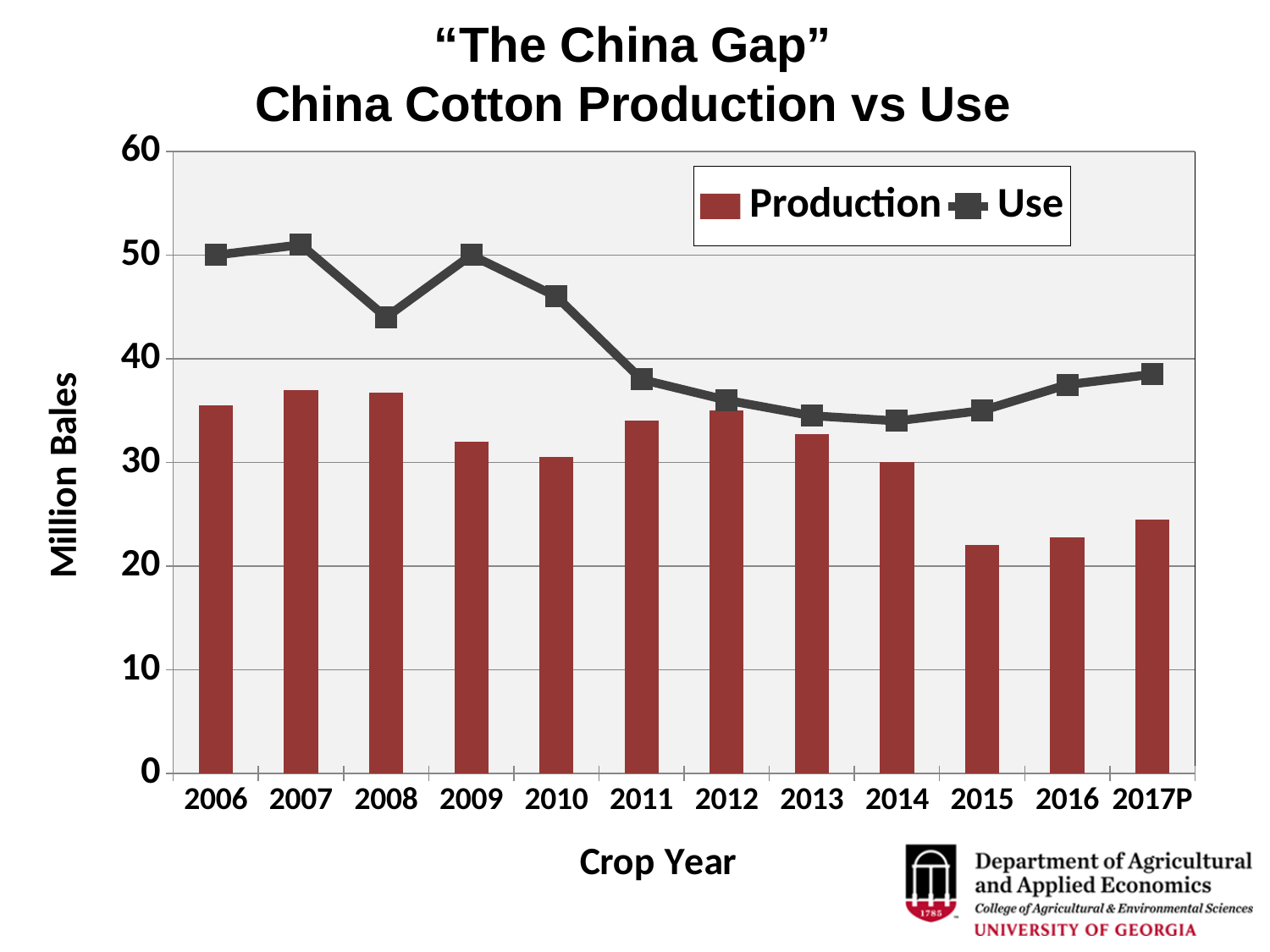
In 2006, which is larger, Production or Use? Use Is the Use value for 2006 greater or less than 40? greater Does the Use series generally rise or fall from 2006 to 2014? fall Which is larger, Production in 2007 or Production in 2015? 2007 How many crop years are shown on the x axis? 12 What is the label of the y axis? Million Bales How many series does the legend list? 2 Is the Use value for 2014 greater or less than 40? less What kind of chart is shown on the slide? A combined bar and line chart Which series is drawn as bars, Production or Use? Production Is the Production value for 2006 greater or less than 30? greater